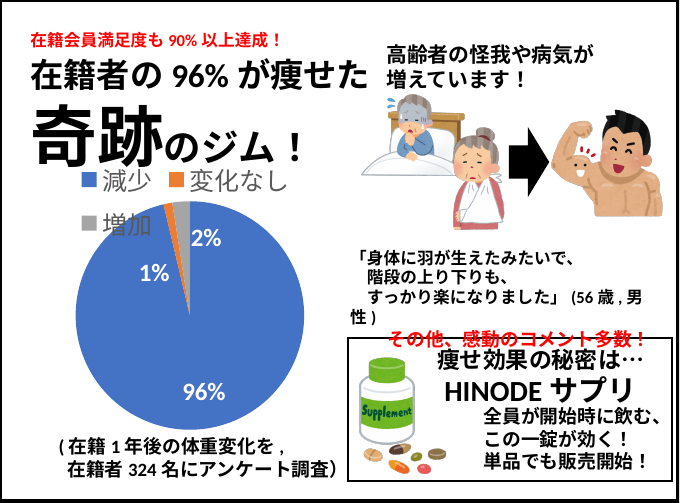
What colour is the 減少 slice in the pie chart? blue Which category has the largest share of the pie chart? 減少 Which legend entry is shown in orange? 変化なし What is the smallest percentage label shown on the pie chart? 1% What type of chart is shown on the slide? pie chart How many categories does the pie chart's legend list? 3 Is the share for 減少 greater or less than 50%? greater Which is larger on the pie chart: the share for 減少 or the share for 変化なし? 減少 How many respondents were surveyed according to the note under the pie chart? 324名 What percentage of the pie chart is labelled for 減少? 96%